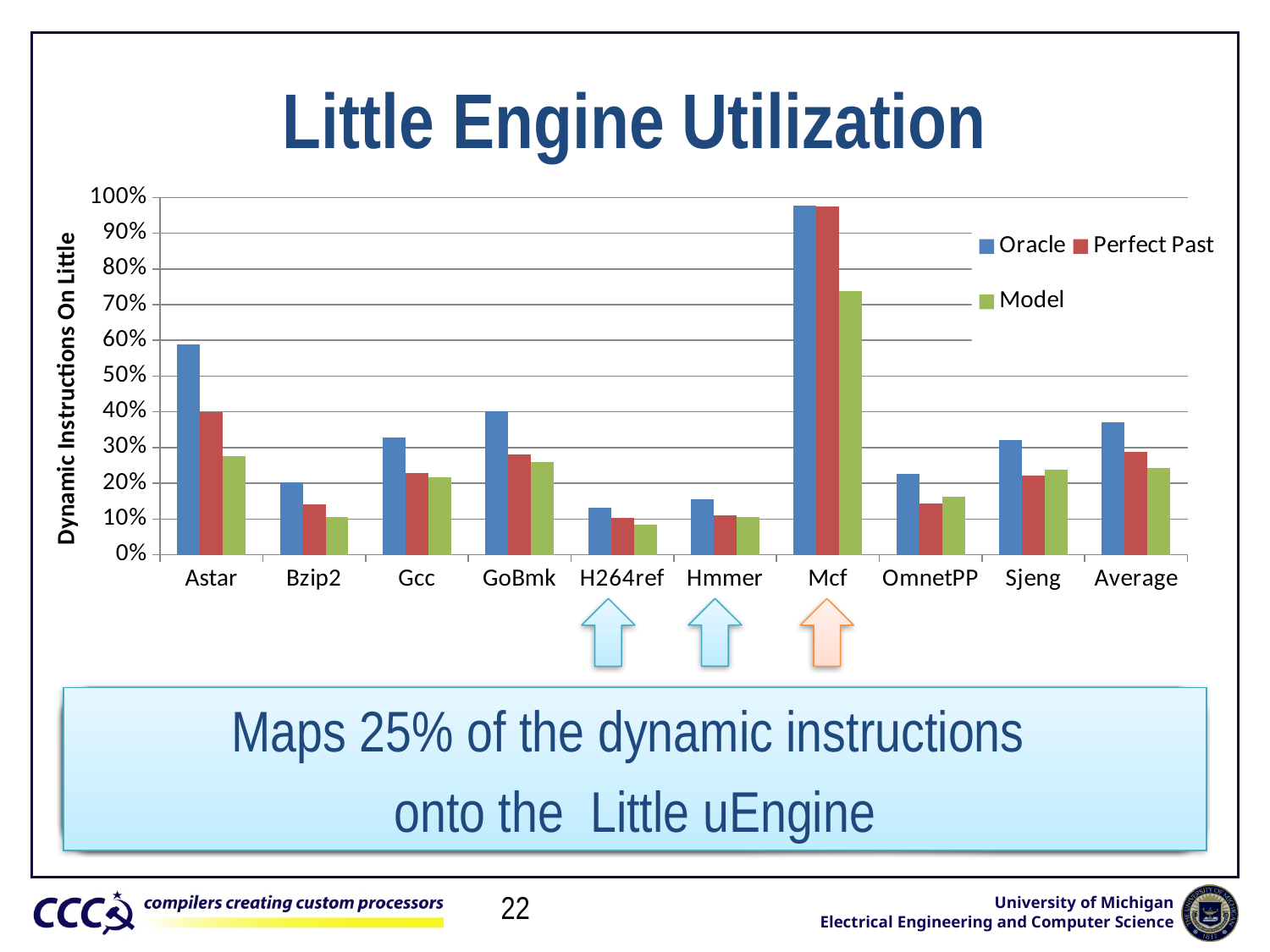
How many series does the legend list? 3 How many categories are shown along the x axis? 10 Is the Oracle value for Astar greater or less than 50%? greater Is the Oracle value for Average greater or less than 30%? greater What is the title of the y axis? Dynamic Instructions On Little Which category has the highest Model value? Mcf Which has the larger Oracle value, Astar or Bzip2? Astar What kind of chart is shown on the slide? bar chart Which has the larger Oracle value, GoBmk or Gcc? GoBmk Which category has the highest Oracle value? Mcf Is the Model value for Mcf greater or less than 70%? greater